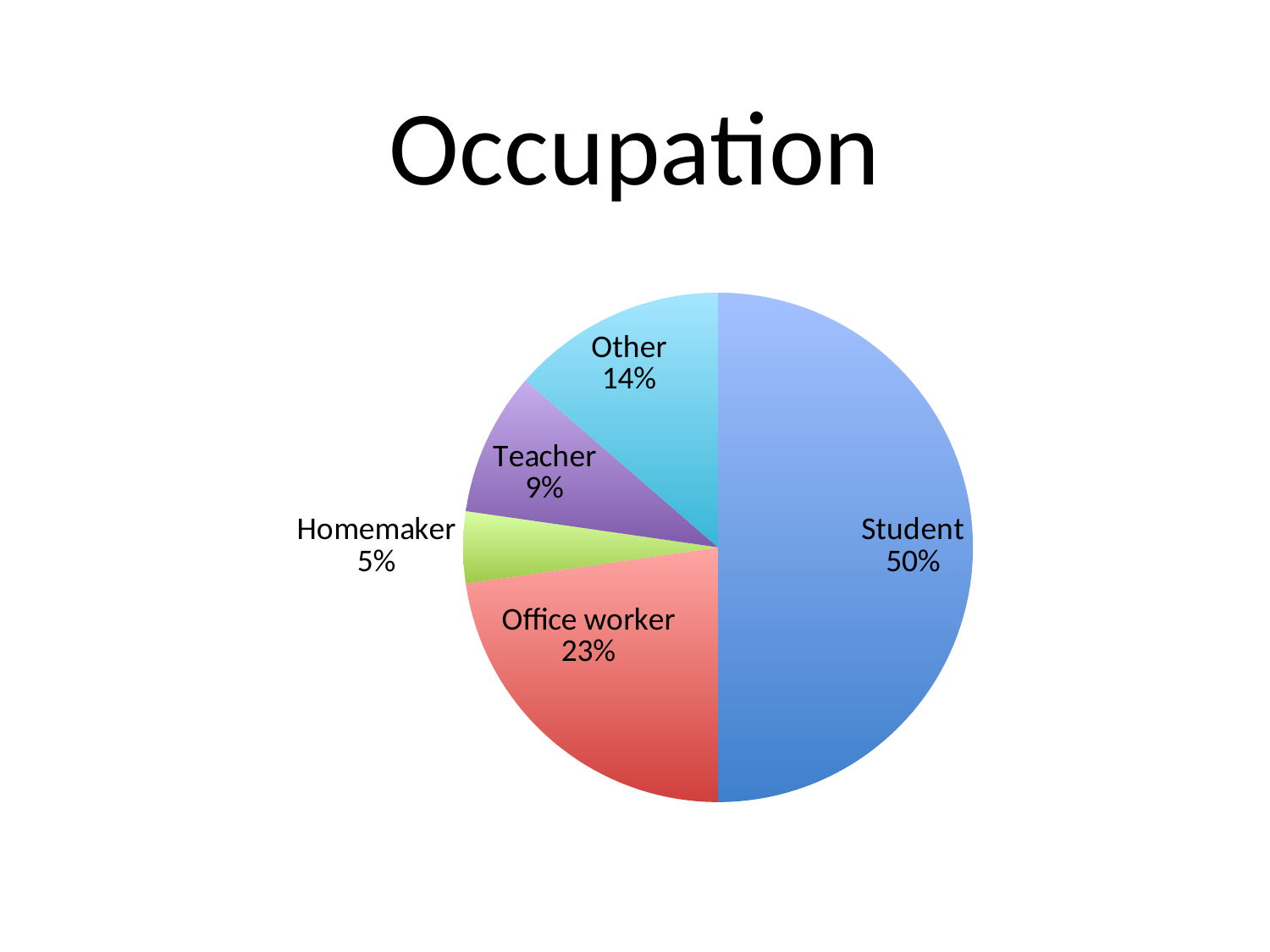
Which category has the largest slice? Student Which category has the smallest slice? Homemaker What is the title of the slide? Occupation What share of the pie does Student represent? 50% What is the value shown for Homemaker? 5% What is the value shown for Other? 14% What is the value shown for Office worker? 23% What is the difference between the Student and Office worker shares? 27% How many categories are shown in the pie chart? 5 What is the value shown for Teacher? 9% What kind of chart is shown on the slide? Pie chart Which is larger, Other or Teacher? Other